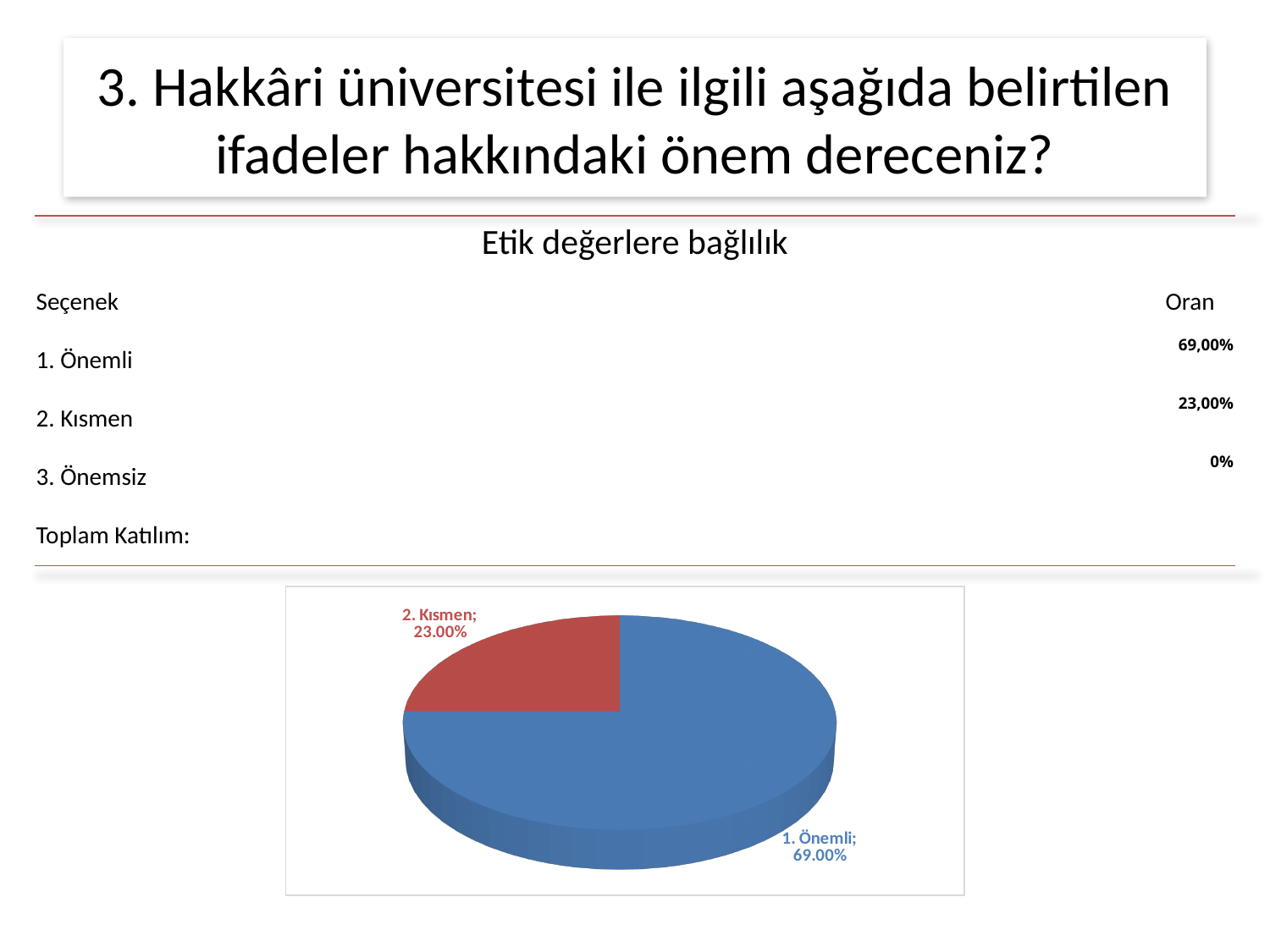
What colour is the "2. Kısmen" slice in the pie chart? red Which is larger in the pie chart, "1. Önemli" or "2. Kısmen"? 1. Önemli What kind of chart is shown at the bottom of the slide? pie chart What is the value shown for the slice labelled "2. Kısmen" in the pie chart? 23.00% What is the value shown for the slice labelled "1. Önemli" in the pie chart? 69.00% Which labelled slice of the pie chart is the smallest? 2. Kısmen Which slice of the pie chart is the largest? 1. Önemli Is the value for "1. Önemli" in the pie chart greater or less than 50%? greater What is the difference between the values for "1. Önemli" and "2. Kısmen" in the pie chart? 46.00% What colour is the "1. Önemli" slice in the pie chart? blue How many labelled slices does the pie chart have? 2 Is the value for "2. Kısmen" in the pie chart greater or less than 50%? less